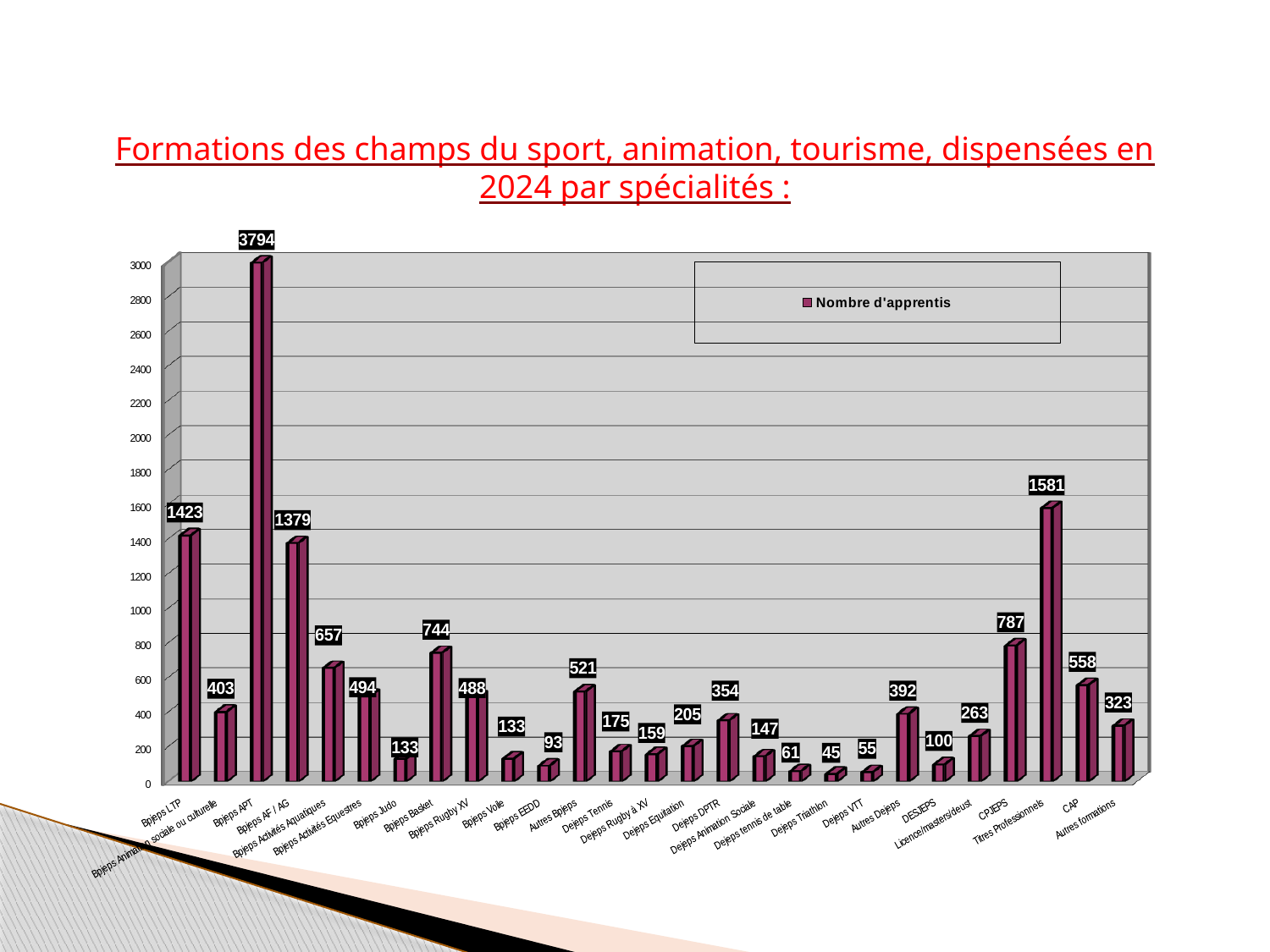
What is the series name shown in the legend? Nombre d'apprentis What is the difference in number of apprentices between Bpjeps LTP and Bpjeps AF / AG? 44 What is the number of apprentices for Titres Professionnels? 1581 Which category has the lowest number of apprentices? Dejeps Triathlon What is the number of apprentices for Bpjeps APT? 3794 Which has more apprentices, CPJEPS or CAP? CPJEPS How many categories are shown on the x axis of the chart? 27 What is the number of apprentices for Dejeps DPTR? 354 Which category has the highest number of apprentices? Bpjeps APT What type of chart is shown on the slide? bar chart What is the number of apprentices for Bpjeps Basket? 744 How many series does the legend list? 1